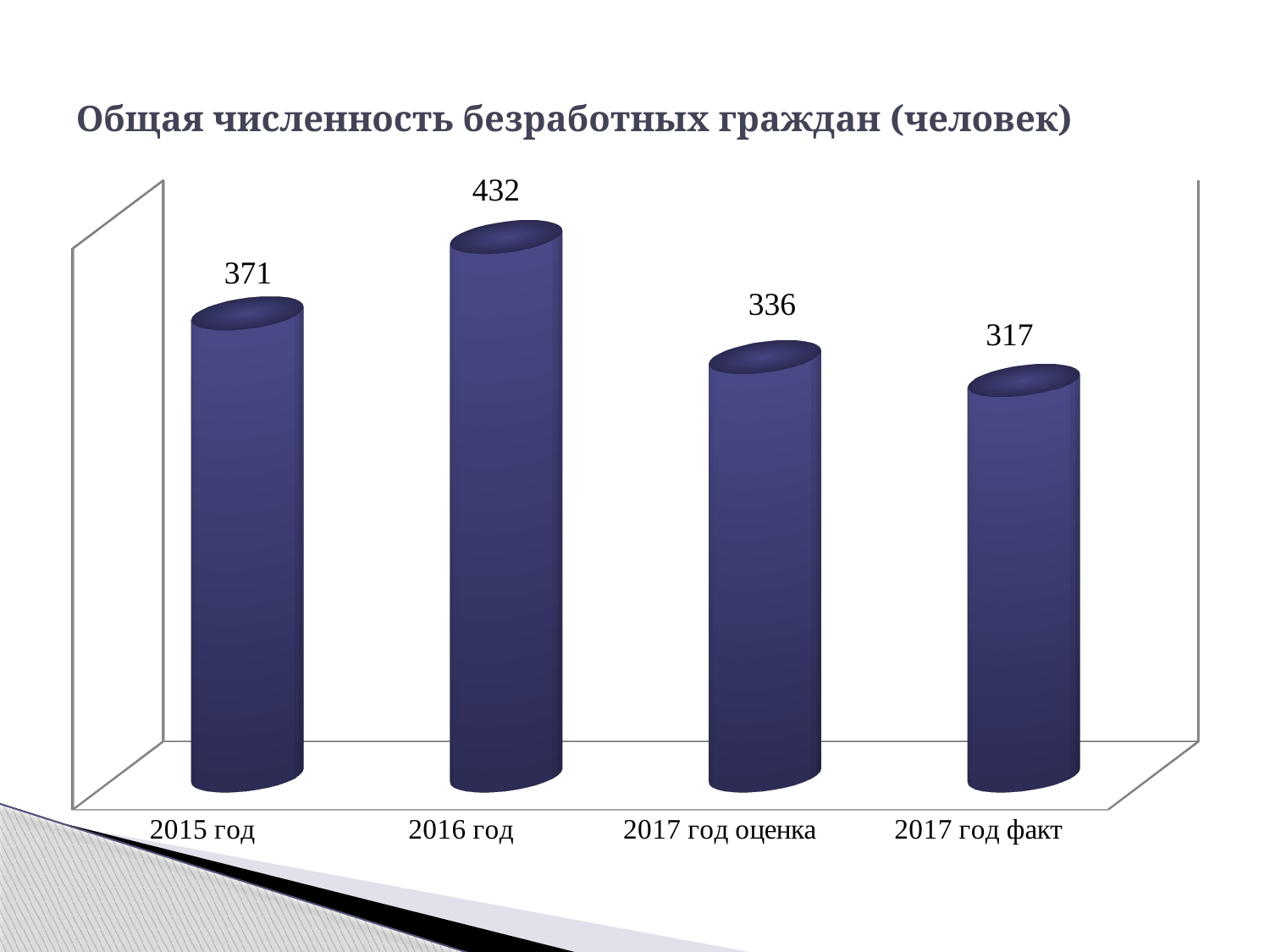
What is the difference between the values for 2016 год and 2015 год? 61 Which category has the highest value? 2016 год What is the value for 2015 год? 371 How many categories are shown on the chart? 4 What is the value for 2016 год? 432 What is the difference between the values for 2017 год оценка and 2017 год факт? 19 Which is larger, the value for 2015 год or the value for 2017 год оценка? 2015 год Which category has the lowest value? 2017 год факт What is the value for 2017 год факт? 317 What kind of chart is shown on the slide? bar chart What is the title of the chart? Общая численность безработных граждан (человек) What is the value for 2017 год оценка? 336